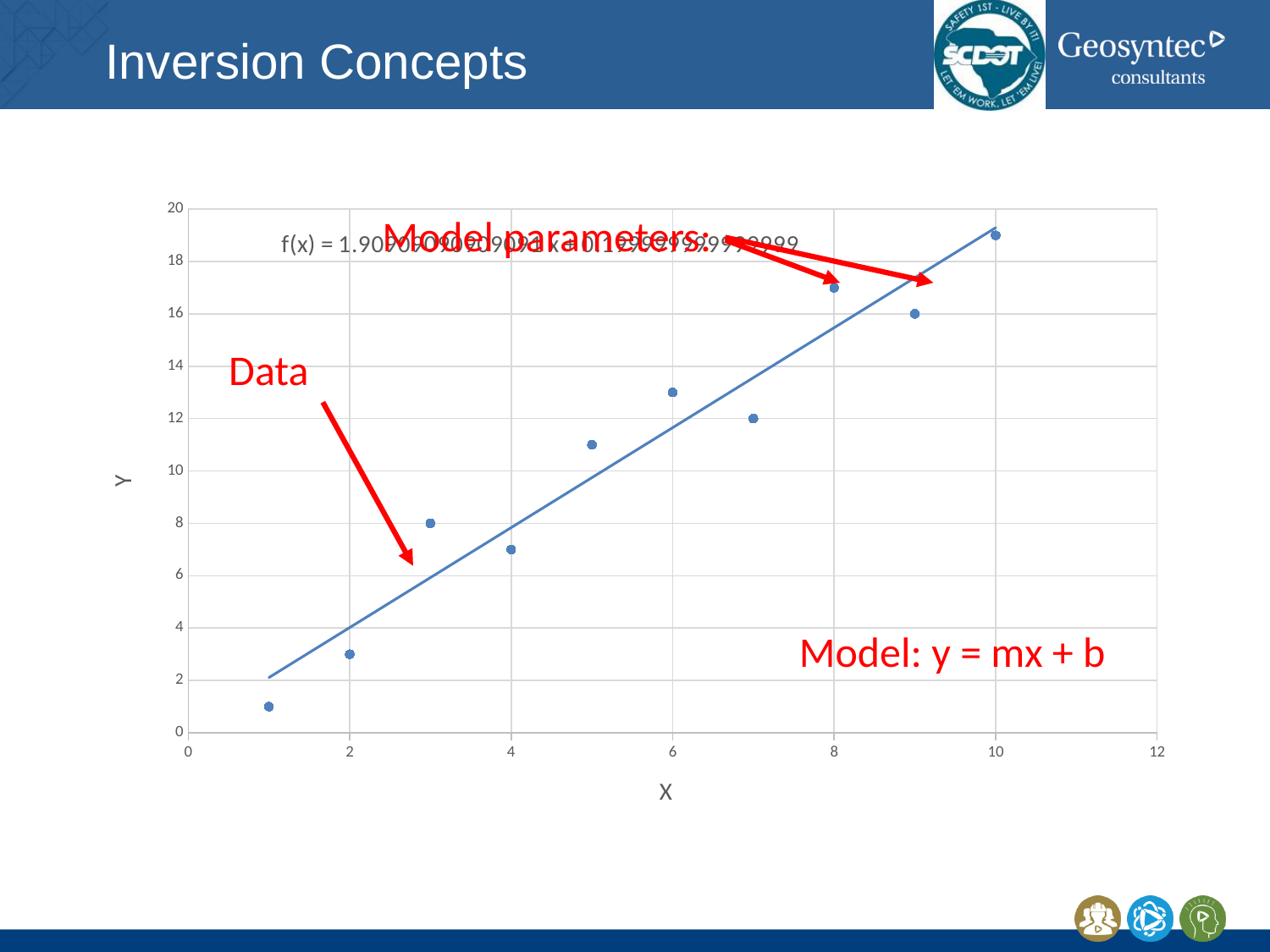
Is the Y value of the point at X = 6 greater or less than 12? greater At which X value is the lowest plotted Y value? 1 Which point has the larger Y value, the one at X = 6 or the one at X = 4? X = 6 What model equation is written in red on the chart? Model: y = mx + b What kind of chart is shown on the slide? scatter chart How many data points are plotted in the chart? 10 Is the Y value of the point at X = 4 greater or less than 8? less At which X value is the highest plotted Y value? 10 Is the Y value of the point at X = 1 greater or less than 2? less Do the plotted Y values generally rise or fall as X increases? rise What is the label on the horizontal axis of the chart? X